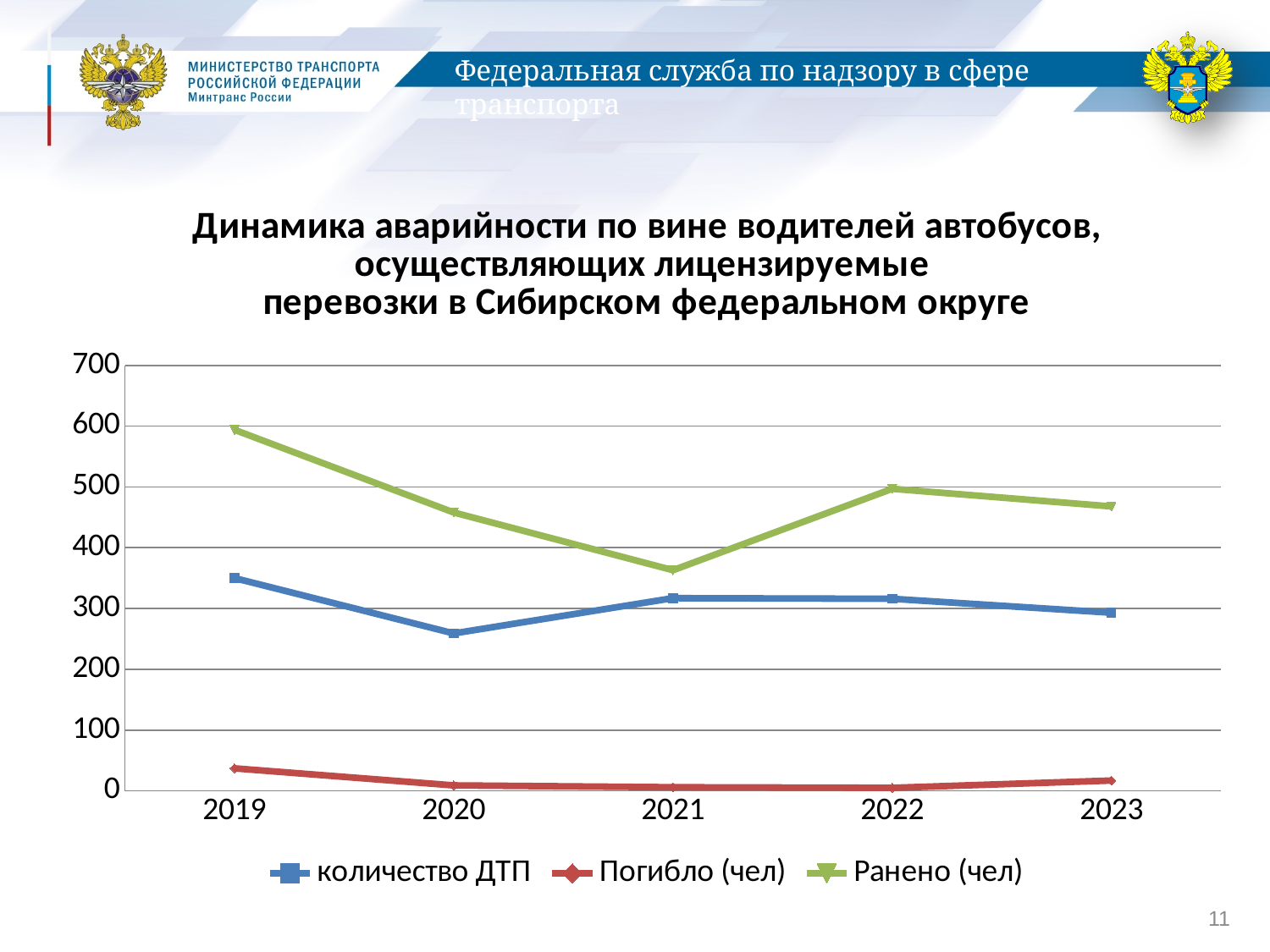
What kind of chart is shown on the slide? line chart Does the value for Ранено (чел) rise or fall from 2019 to 2021? fall How many years are plotted along the x axis? 5 Which is larger: the value for Ранено (чел) in 2020 or in 2021? 2020 In which year is the value for количество ДТП highest? 2019 Is the value for Ранено (чел) in 2019 greater or less than 500? greater Is the value for Погибло (чел) in 2019 greater or less than 100? less In which year is the value for Ранено (чел) highest? 2019 In which year is the value for Ранено (чел) lowest? 2021 How many series does the legend list? 3 Is the value for количество ДТП in 2020 greater or less than 300? less In which year is the value for количество ДТП lowest? 2020